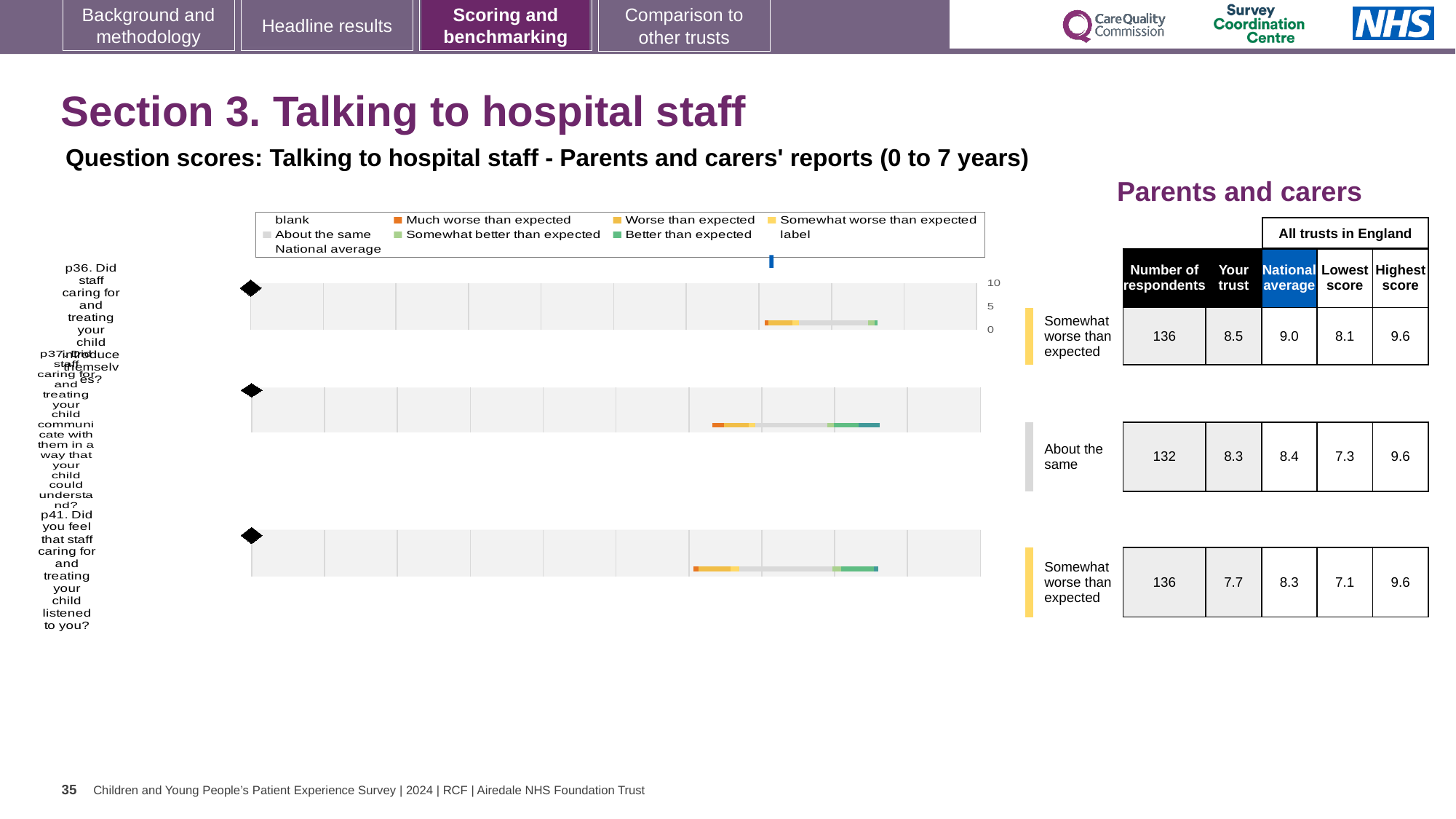
What benchmark category is shown for question p37 (Did staff communicate with them in a way that your child could understand?)? About the same Which legend entry is shown in orange? Much worse than expected Which question has the lowest 'Your trust' score? p41 What is the lowest score among all trusts in England for question p41? 7.1 For question p37, which is larger: the 'Your trust' score or the national average? National average What is the difference between the national average and the 'Your trust' score for question p41? 0.6 Which question has the highest 'Your trust' score? p36 What is the national average score for question p36? 9.0 What is the 'Your trust' score for question p41 (Did you feel that staff caring for and treating your child listened to you?)? 7.7 What is the 'Your trust' score for question p36 (Did staff caring for and treating your child introduce themselves?)? 8.5 How many respondents answered question p37? 132 How many survey questions are plotted in the benchmark charts on this slide? 3